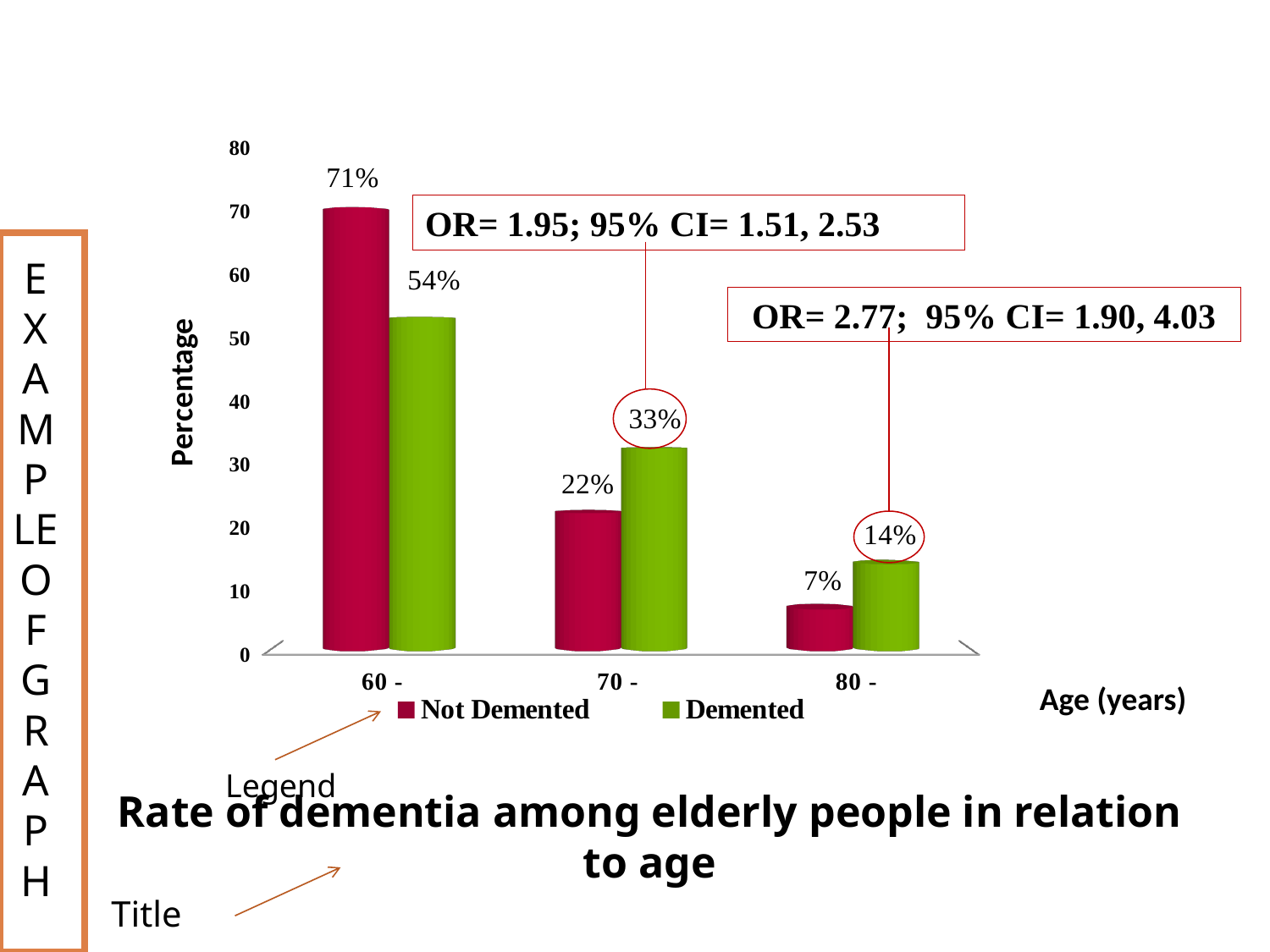
Do the Not Demented percentages rise or fall as age increases along the x axis? Fall For the 70 - age group, which is larger: the Demented or the Not Demented percentage? Demented Which age group has the highest Demented percentage? 60 - What is the Demented percentage for the 70 - age group? 33% How many series does the legend list? 2 What is the title of the chart? Rate of dementia among elderly people in relation to age How many age groups are shown on the x axis? 3 What kind of chart is shown on the slide? Bar chart Which age group has the lowest Not Demented percentage? 80 - What is the Not Demented percentage for the 60 - age group? 71% What is the difference between the Not Demented and Demented percentages for the 60 - age group? 17% What is the Not Demented percentage for the 80 - age group? 7%